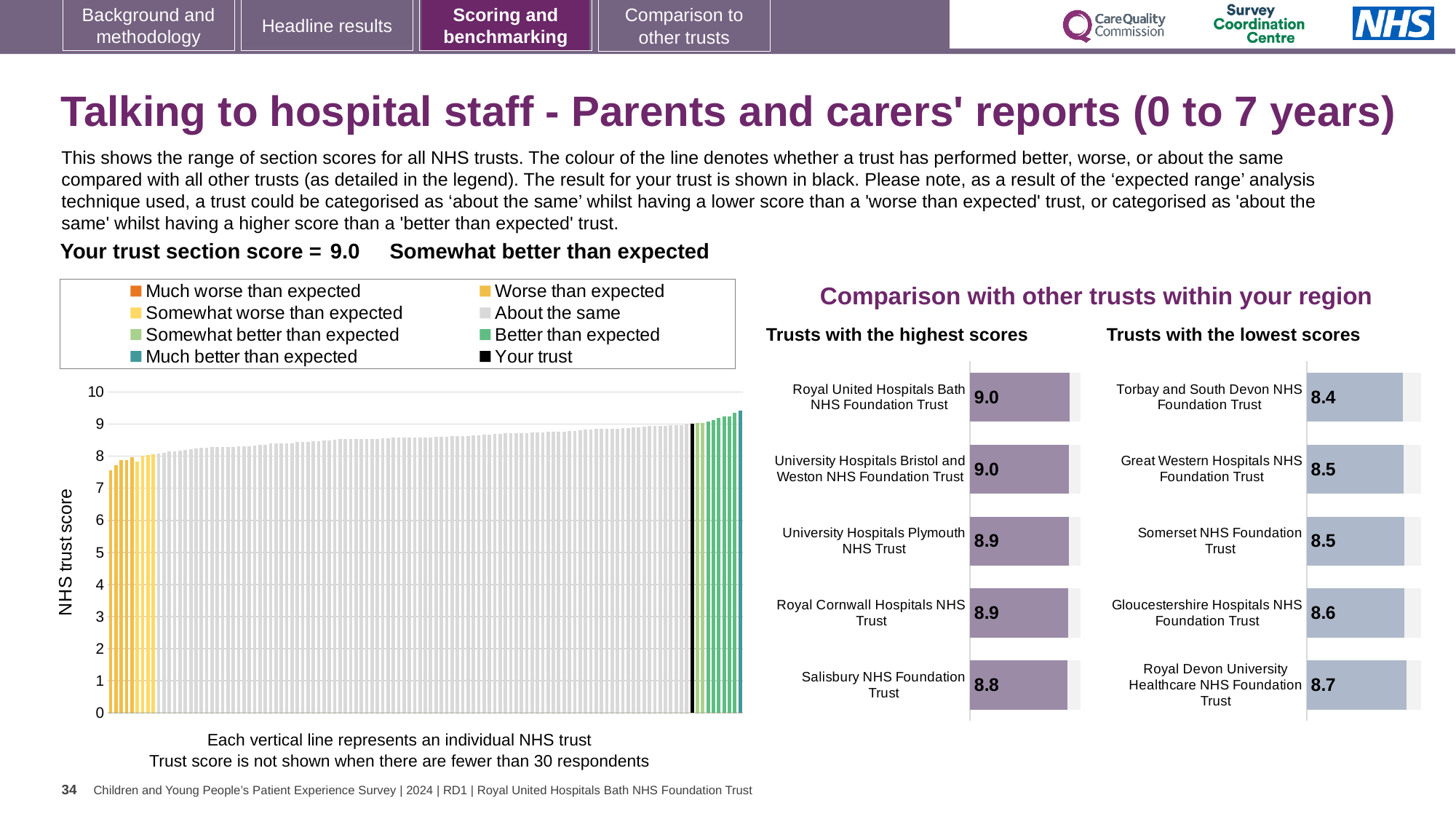
In the main chart on the left showing all NHS trusts, is the value of the leftmost (lowest) bar greater or less than 8? less In the main chart on the left showing all NHS trusts, what is the label of the y-axis? NHS trust score In the main chart on the left showing all NHS trusts, how many entries does the legend list? 8 In the 'Trusts with the lowest scores' chart, which trust has the lowest score? Torbay and South Devon NHS Foundation Trust In the 'Trusts with the highest scores' chart, what is the score for Salisbury NHS Foundation Trust? 8.8 In the 'Trusts with the lowest scores' chart, how many trusts are shown? 5 In the 'Trusts with the highest scores' chart, what is the difference between the score for Royal United Hospitals Bath NHS Foundation Trust and the score for Salisbury NHS Foundation Trust? 0.2 In the 'Trusts with the highest scores' chart, which has the higher score: University Hospitals Plymouth NHS Trust or Salisbury NHS Foundation Trust? University Hospitals Plymouth NHS Trust What kind of chart is the main chart on the left showing all NHS trusts? Bar chart In the 'Trusts with the lowest scores' chart, what is the difference between the score for Royal Devon University Healthcare NHS Foundation Trust and the score for Torbay and South Devon NHS Foundation Trust? 0.3 In the 'Trusts with the lowest scores' chart, what is the score for Gloucestershire Hospitals NHS Foundation Trust? 8.6 In the main chart on the left showing all NHS trusts, do the bar values rise or fall from left to right? Rise